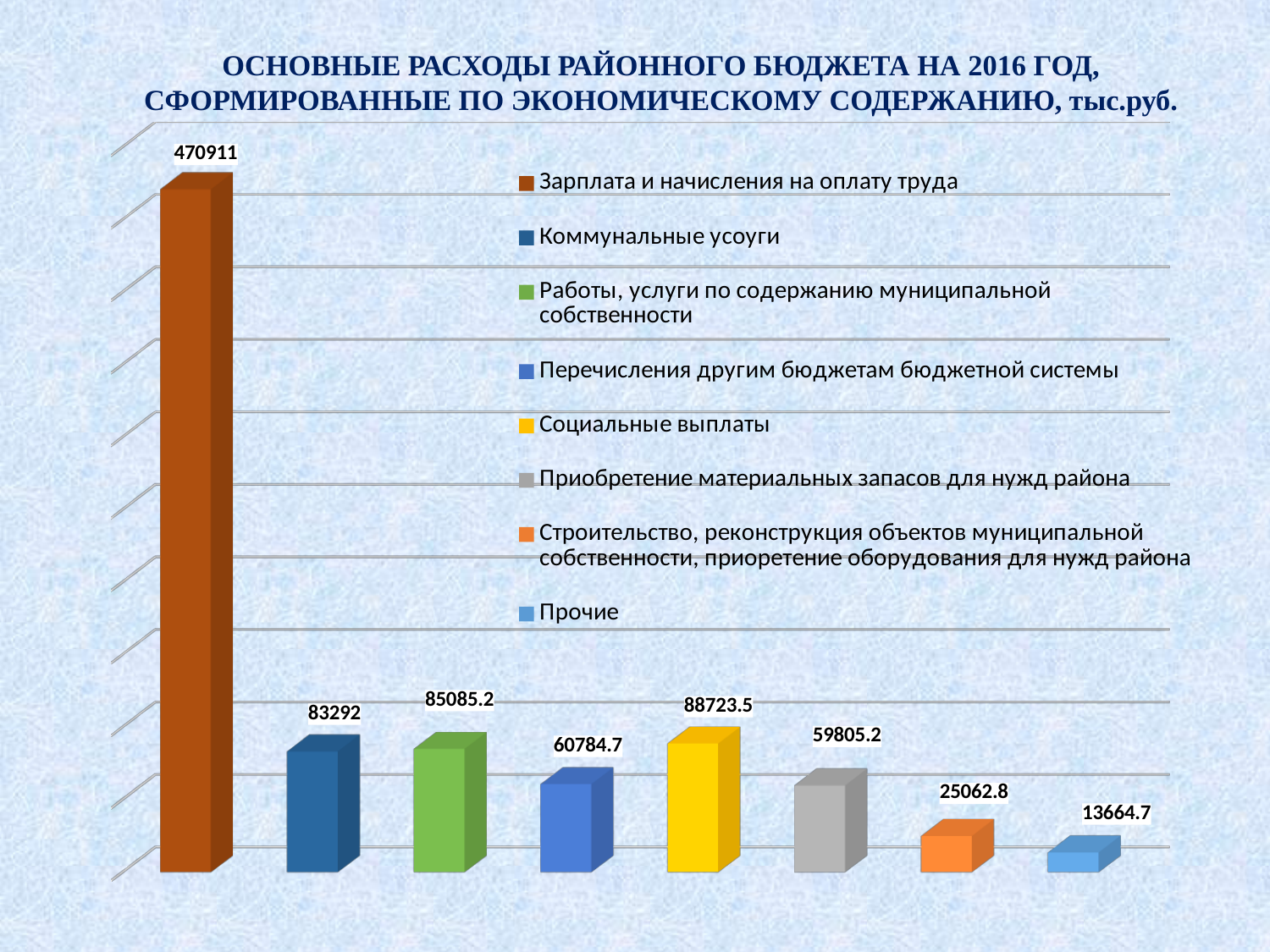
Which category has the highest value? Зарплата и начисления на оплату труда What is the value for Зарплата и начисления на оплату труда? 470911 What is the value for Приобретение материальных запасов для нужд района? 59805.2 What is the difference between Зарплата и начисления на оплату труда and Коммунальные усоуги? 387619 What is the difference between Строительство, реконструкция объектов муниципальной собственности, приоретение оборудования для нужд района and Прочие? 11398.1 How many bars are plotted in the chart? 8 Which is larger: Коммунальные усоуги or Перечисления другим бюджетам бюджетной системы? Коммунальные усоуги What is the value for Социальные выплаты? 88723.5 What kind of chart is shown on the slide? Bar chart What is the value for Прочие? 13664.7 How many entries does the legend list? 8 Which category has the lowest value? Прочие